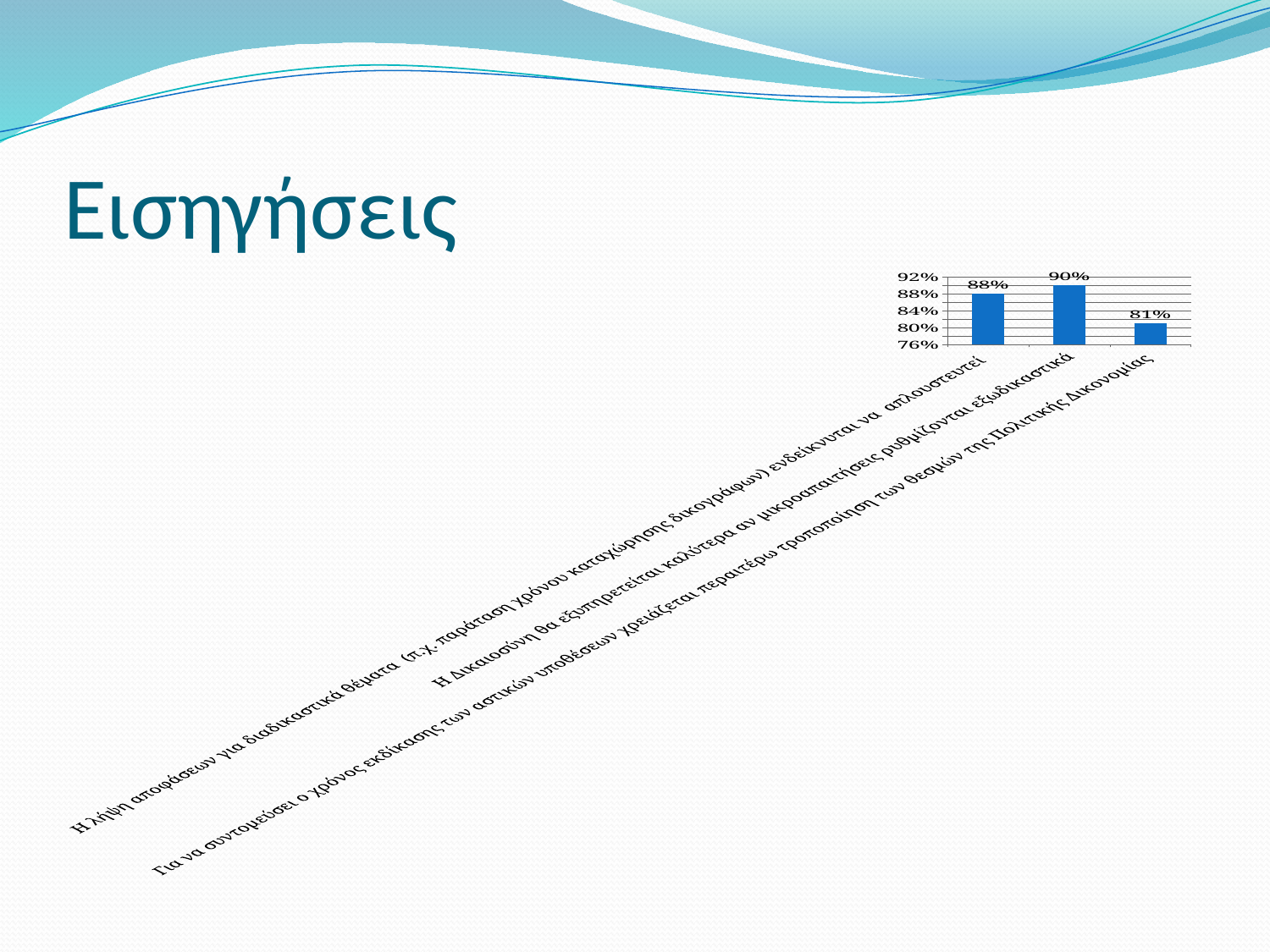
How many bars does the chart show? 3 What is the value for the statement that small claims should be settled out of court ("Η Δικαιοσύνη θα εξυπηρετείται καλύτερα αν μικροαπαιτήσεις ρυθμίζονται εξωδικαστικά")? 90% Which statement has the highest value in the chart? Η Δικαιοσύνη θα εξυπηρετείται καλύτερα αν μικροαπαιτήσεις ρυθμίζονται εξωδικαστικά Is the value for the statement about amending the Civil Procedure institutions greater or less than 84%? less What is the value for the statement that decision-making on procedural matters should be simplified ("Η λήψη αποφάσεων για διαδικαστικά θέματα ... ενδείκνυται να απλουστευτεί")? 88% What is the difference between the highest value (90%) and the lowest value (81%) in the chart? 9% What type of chart is shown on the slide? bar chart Which is larger: the value for simplifying procedural decision-making (88%) or the value for settling small claims out of court (90%)? settling small claims out of court (90%) Which statement has the lowest value in the chart? Για να συντομεύσει ο χρόνος εκδίκασης των αστικών υποθέσεων χρειάζεται περαιτέρω τροποποίηση των θεσμών της Πολιτικής Δικονομίας What is the title of the slide containing the chart? Εισηγήσεις What is the lowest value shown on the chart's vertical axis? 76% What is the value for the statement that further amendment of the Civil Procedure institutions is needed ("... χρειάζεται περαιτέρω τροποποίηση των θεσμών της Πολιτικής Δικονομίας")? 81%